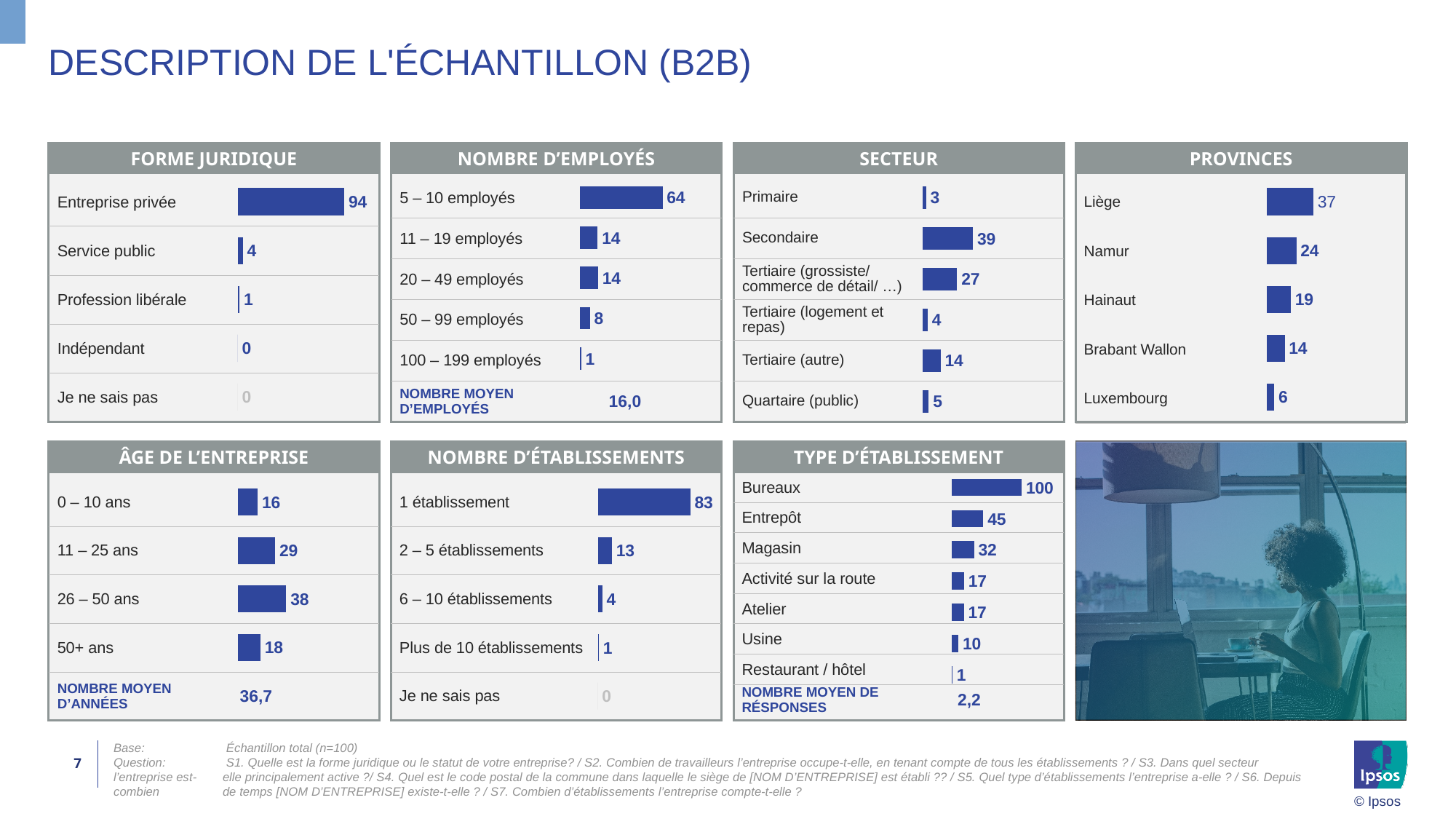
In the PROVINCES chart, which province has the lowest value? Luxembourg In the FORME JURIDIQUE chart, what is the value for Entreprise privée? 94 What kind of chart is used in the SECTEUR panel? Bar chart In the TYPE D'ÉTABLISSEMENT chart, what is the value for Entrepôt? 45 In the TYPE D'ÉTABLISSEMENT chart, what is the difference between Bureaux and Magasin? 68 In the NOMBRE D'ÉTABLISSEMENTS chart, what is the value for 1 établissement? 83 What is the NOMBRE MOYEN D'ANNÉES shown in the ÂGE DE L'ENTREPRISE chart? 36,7 In the ÂGE DE L'ENTREPRISE chart, how many age categories are shown? 4 In the PROVINCES chart, which is larger, Namur or Hainaut? Namur In the SECTEUR chart, what is the difference between Secondaire and Tertiaire (grossiste/ commerce de détail/ …)? 12 In the NOMBRE D'EMPLOYÉS chart, which category has the highest value? 5 – 10 employés In the ÂGE DE L'ENTREPRISE chart, what is the value for 26 – 50 ans? 38